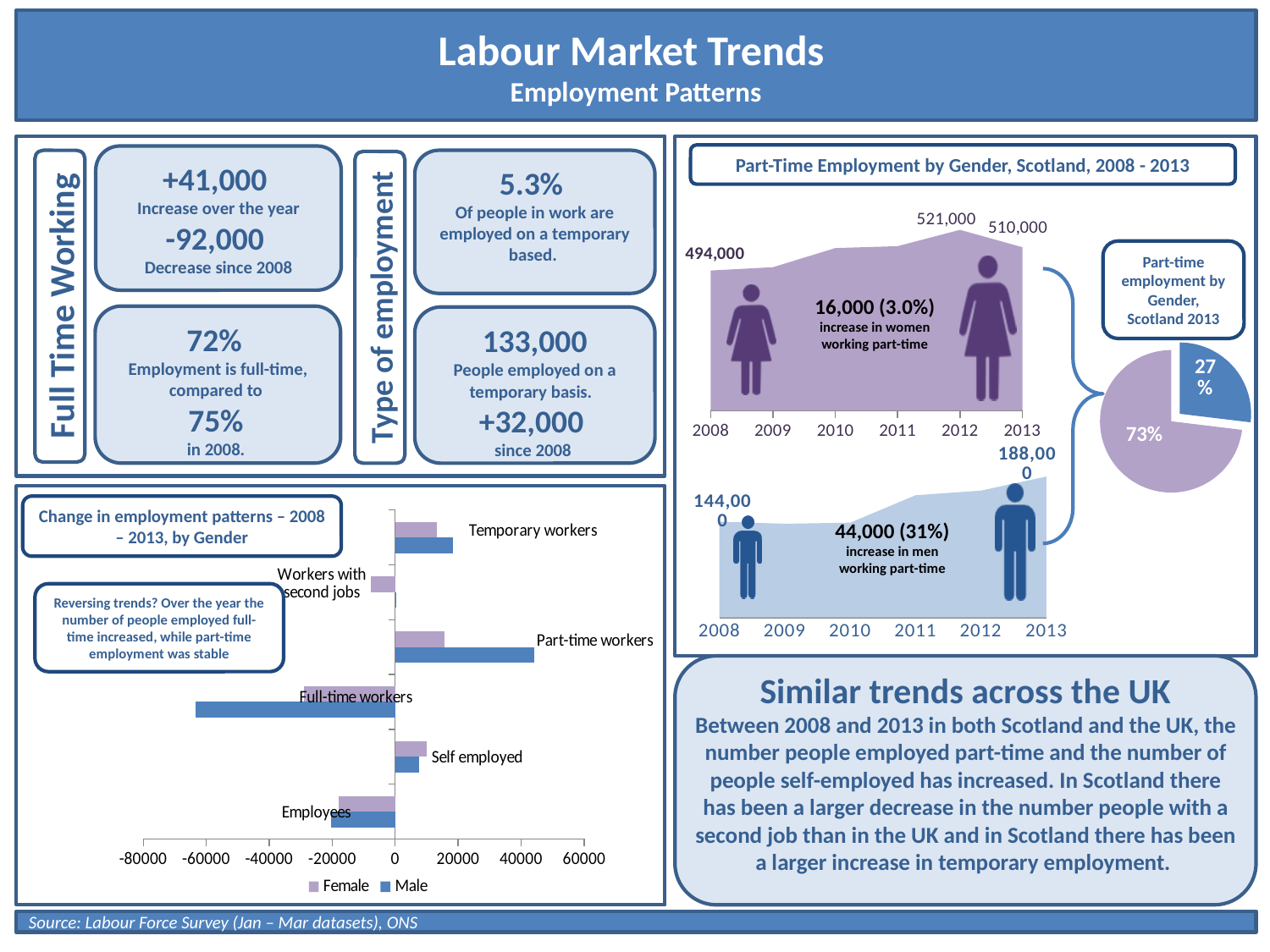
In the 'Part-Time Employment by Gender, Scotland, 2008 - 2013' chart, what is the difference between the number of men working part-time in 2013 and in 2008? 44,000 In the 'Part-Time Employment by Gender, Scotland, 2008 - 2013' chart, what was the number of women working part-time in 2008? 494,000 In the 'Change in employment patterns – 2008 – 2013, by Gender' chart, is the Male value for Full-time workers greater or less than -40000? less In the 'Change in employment patterns – 2008 – 2013, by Gender' chart, is the Male value for Part-time workers greater or less than 20000? greater In the 'Change in employment patterns – 2008 – 2013, by Gender' chart, which colour represents the Female series? purple In the 'Part-time employment by Gender, Scotland 2013' pie chart, what share does the larger slice represent? 73% In the 'Part-Time Employment by Gender, Scotland, 2008 - 2013' chart, does the number of men working part-time rise or fall from 2008 to 2013? rise In the 'Part-Time Employment by Gender, Scotland, 2008 - 2013' chart, what was the number of men working part-time in 2013? 188,000 In the 'Change in employment patterns – 2008 – 2013, by Gender' chart, which is larger for Part-time workers, the Female or the Male value? Male How many categories are shown in the 'Change in employment patterns – 2008 – 2013, by Gender' chart? 6 How many series does the legend of the 'Change in employment patterns – 2008 – 2013, by Gender' chart list? 2 What kind of chart is the 'Change in employment patterns – 2008 – 2013, by Gender' chart? bar chart